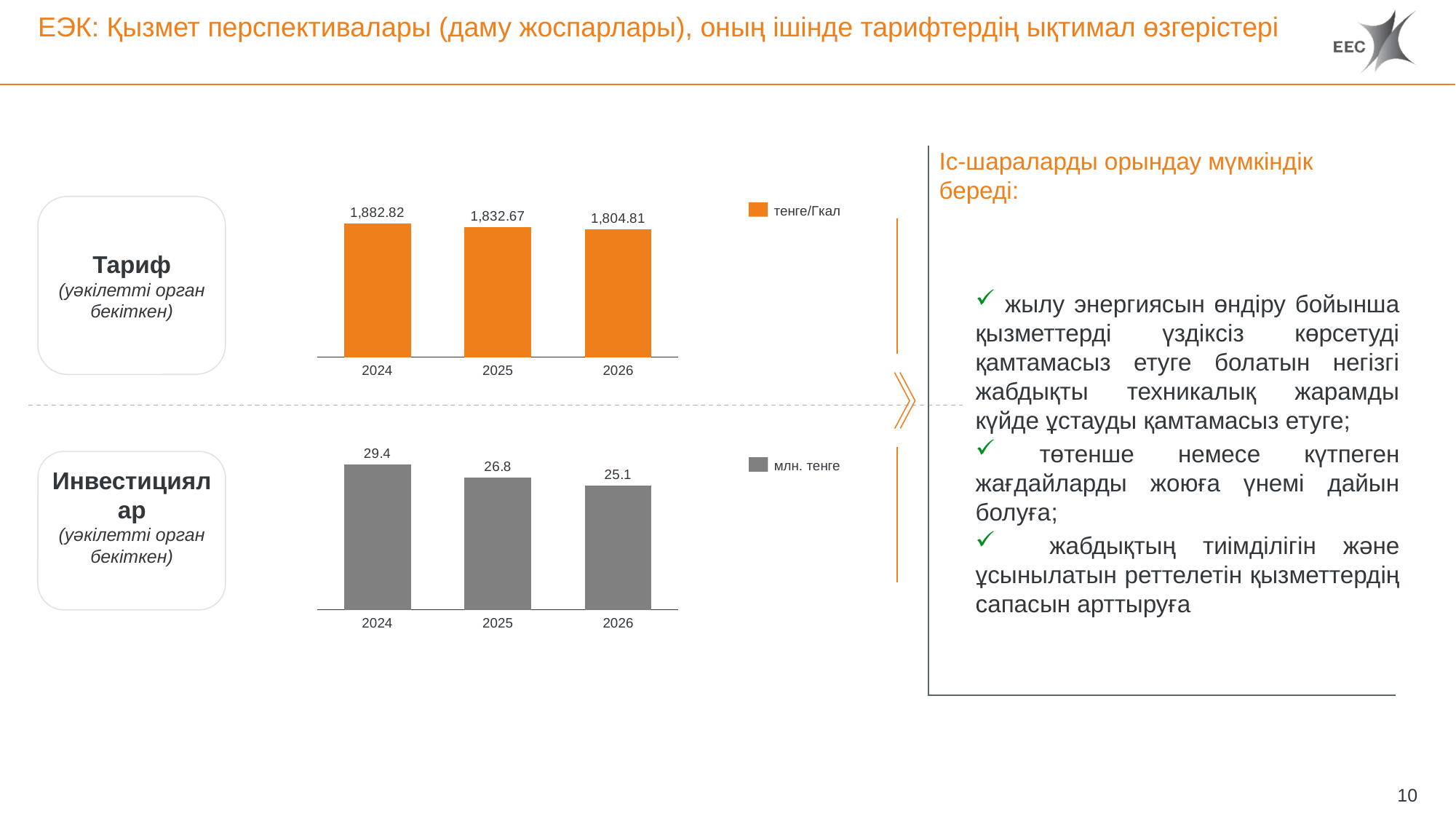
What kind of chart is the bottom chart (Инвестициялар, млн. тенге)? Bar chart In the bottom chart (Инвестициялар, млн. тенге), what is the difference between the 2024 and 2026 values? 4.2 In the bottom chart (Инвестициялар, млн. тенге), which year has the highest value? 2024 In the bottom chart (Инвестициялар, млн. тенге), which is larger, the value for 2025 or the value for 2026? 2025 In the top chart (Тариф, тенге/Гкал), which year has the lowest value? 2026 In the top chart (Тариф, тенге/Гкал), what is the value for 2026? 1,804.81 In the top chart (Тариф, тенге/Гкал), what is the difference between the 2024 and 2025 values? 50.15 In the top chart (Тариф, тенге/Гкал), what is the value for 2024? 1,882.82 In the top chart (Тариф, тенге/Гкал), do the values rise or fall from 2024 to 2026? Fall In the bottom chart (Инвестициялар, млн. тенге), what is the value for 2025? 26.8 What unit does the legend of the bottom chart show? млн. тенге How many years are shown on the x axis of the top chart (Тариф, тенге/Гкал)? 3